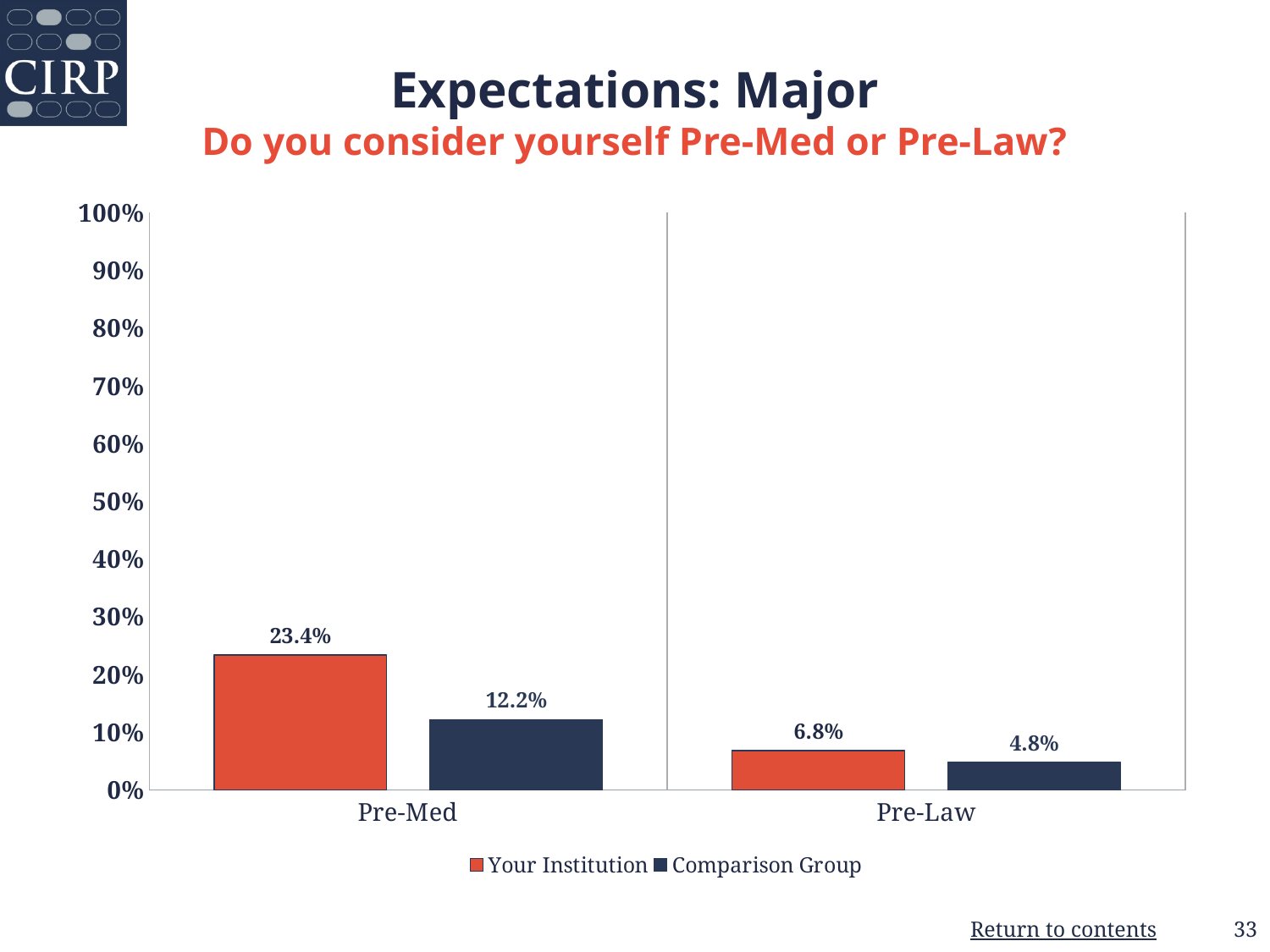
What is the value for Comparison Group for Pre-Law? 4.8% What kind of chart is shown on the slide? Bar chart How many categories are shown on the x axis? 2 What is the difference between Your Institution and Comparison Group for Pre-Med? 11.2% Is the value for Your Institution for Pre-Med greater or less than 20%? greater What is the value for Your Institution for Pre-Law? 6.8% Which is larger for Pre-Law: Your Institution or Comparison Group? Your Institution Which category has the lowest value for Comparison Group? Pre-Law How many series does the legend list? 2 What is the value for Your Institution for Pre-Med? 23.4% Which category has the highest value for Your Institution? Pre-Med What is the value for Comparison Group for Pre-Med? 12.2%